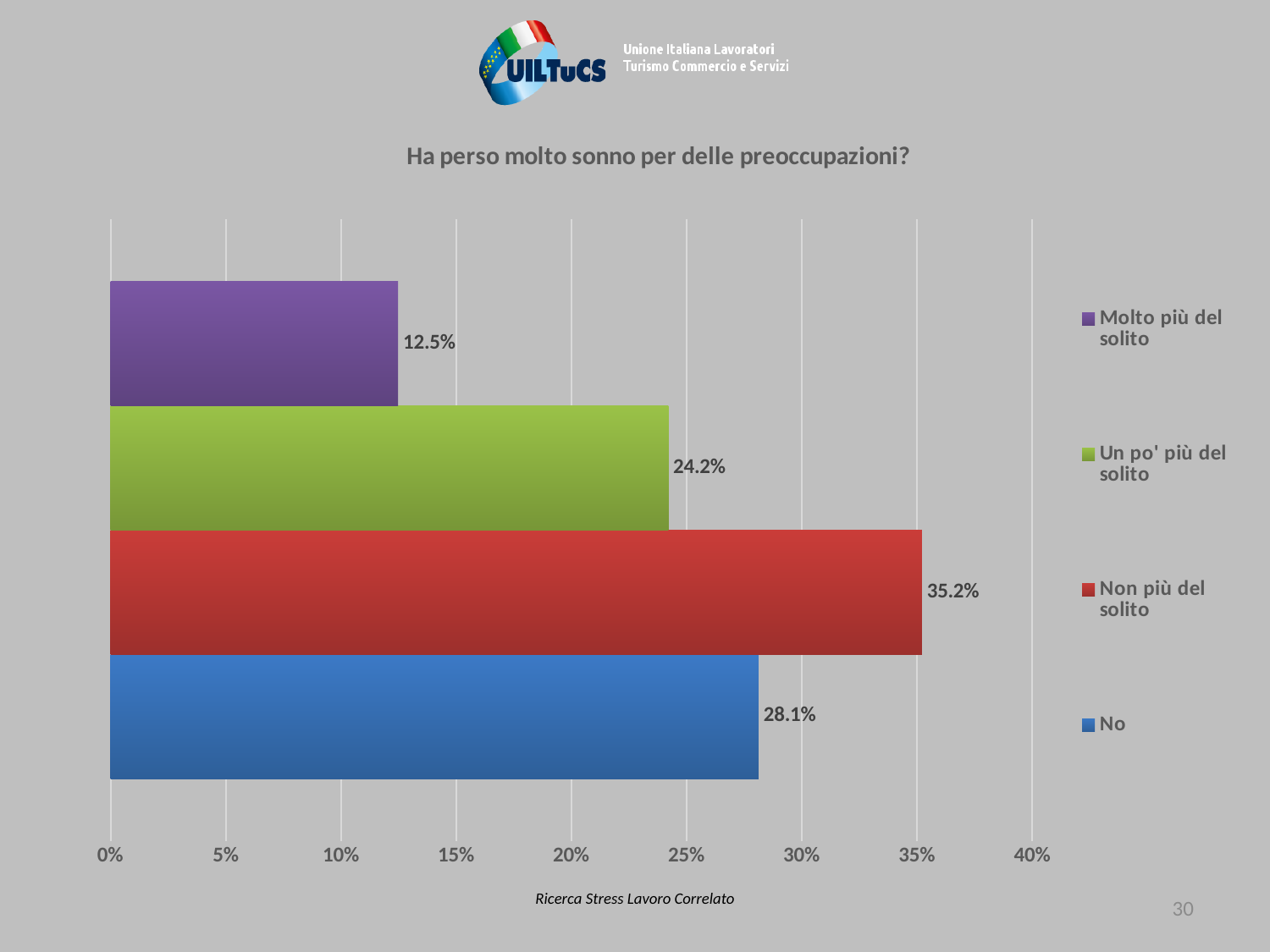
Which category has the lowest value? Molto più del solito What kind of chart is shown on the slide? Bar chart What is the difference between the values for "Non più del solito" and "No"? 7.1% What is the value for "Molto più del solito"? 12.5% What is the title of the chart? Ha perso molto sonno per delle preoccupazioni? What is the value for "Un po' più del solito"? 24.2% Which category has the highest value? Non più del solito Is the value for "Un po' più del solito" greater or less than 25%? less Which is larger, the value for "No" or the value for "Un po' più del solito"? No What is the value for "Non più del solito"? 35.2% What is the value for "No"? 28.1% How many categories are shown in the chart? 4